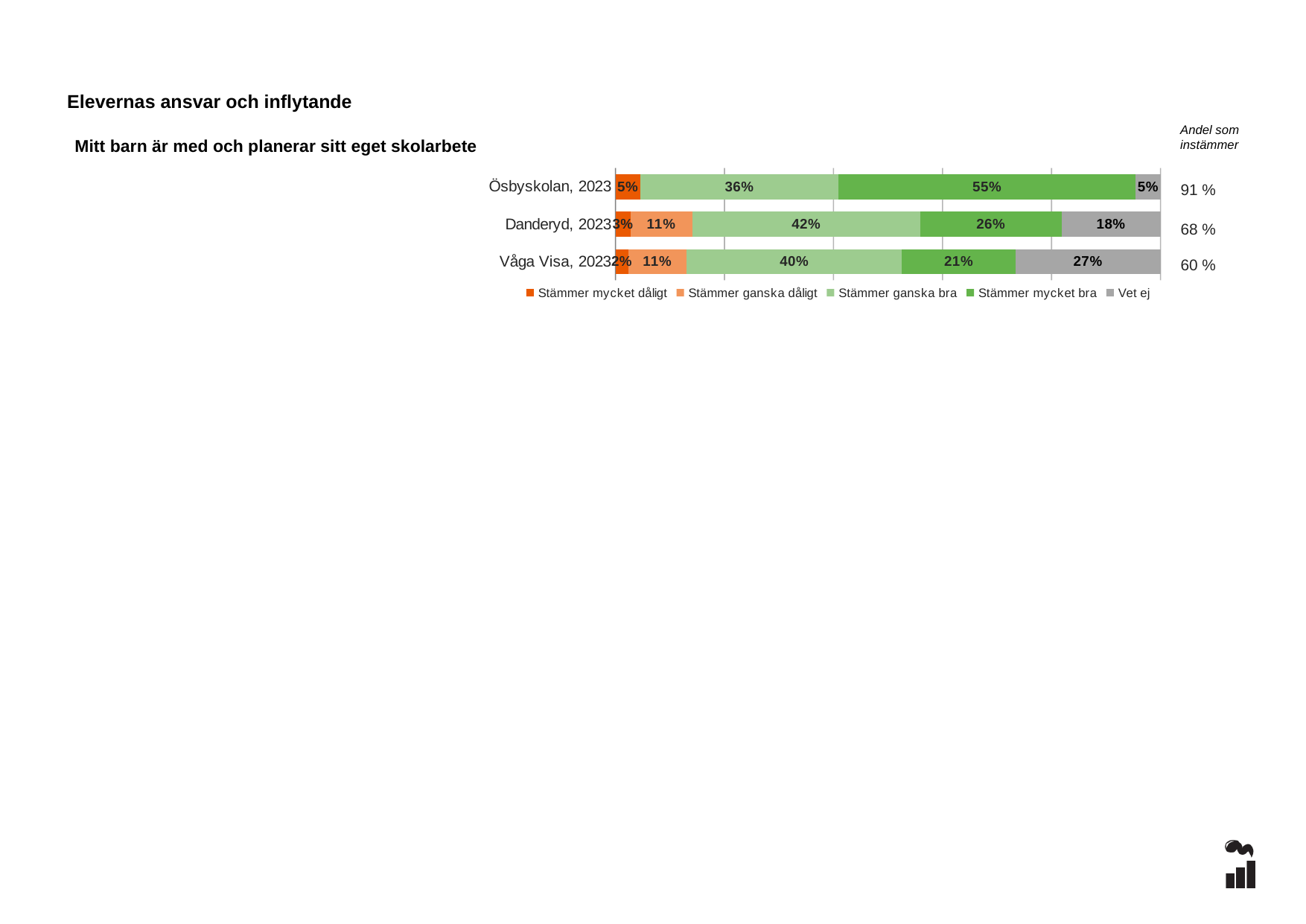
Which is larger: the 'Stämmer ganska bra' value for Danderyd, 2023 or for Våga Visa, 2023? Danderyd, 2023 What is the difference between the 'Stämmer mycket bra' values for Ösbyskolan, 2023 and Danderyd, 2023? 29% What is the value for 'Stämmer ganska bra' for Danderyd, 2023? 42% What is the 'Stämmer ganska dåligt' value for Danderyd, 2023? 11% How many categories (rows) are plotted in the chart? 3 Which category has the lowest 'Vet ej' value? Ösbyskolan, 2023 What is the 'Andel som instämmer' figure shown for Ösbyskolan, 2023? 91 % What kind of chart is shown on the slide? Stacked bar chart What is the 'Vet ej' value for Våga Visa, 2023? 27% Which category has the highest 'Stämmer mycket bra' value? Ösbyskolan, 2023 What is the value for 'Stämmer mycket bra' for Ösbyskolan, 2023? 55% How many series does the legend list? 5